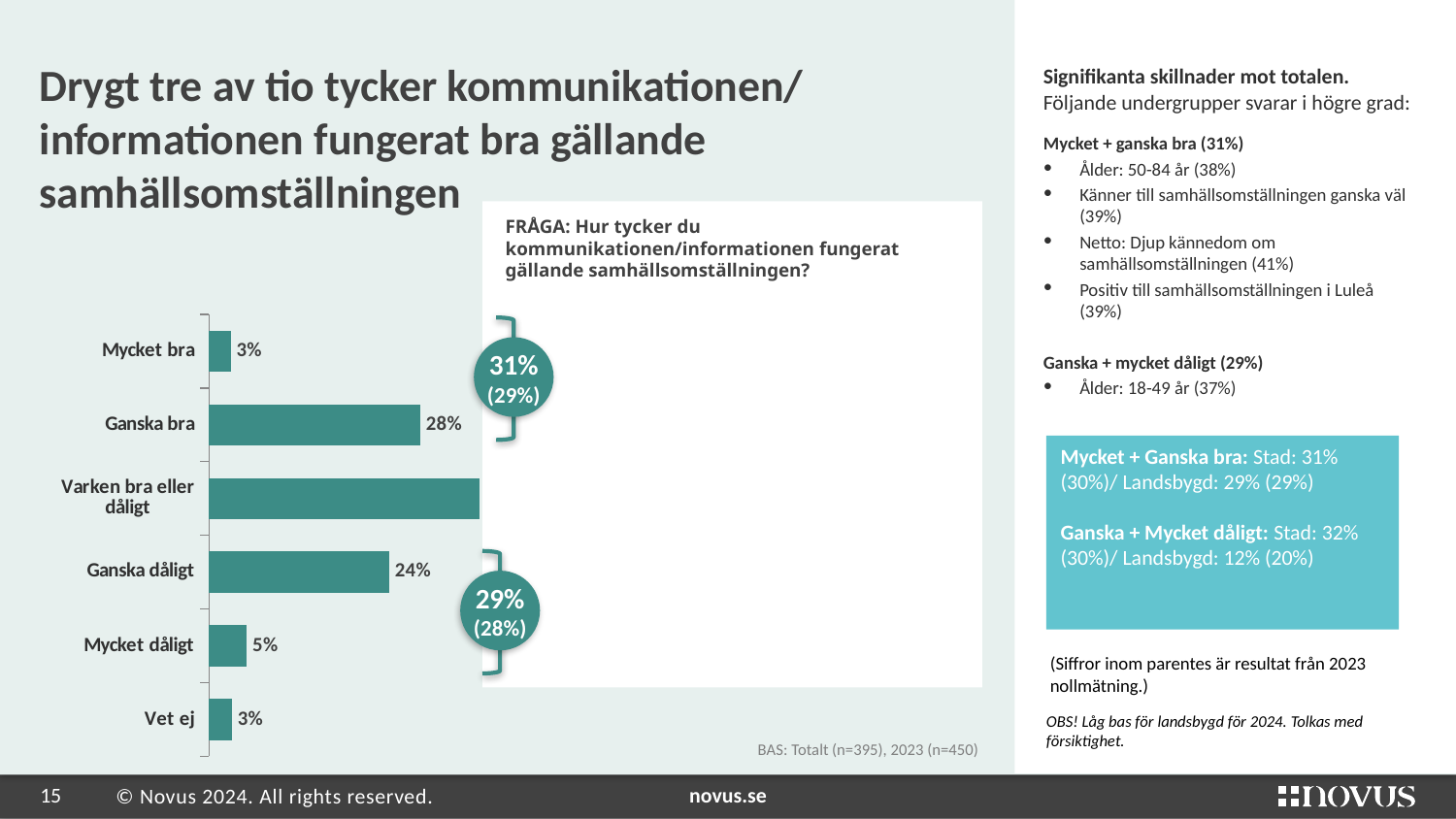
What is the combined share for "Mycket bra" and "Ganska bra" as shown by the bracket label? 31% What is the value shown for "Ganska dåligt"? 24% Which response category has the longest bar in the chart? Varken bra eller dåligt How many response categories are shown in the bar chart? 6 How many percentage points higher is "Ganska bra" than "Ganska dåligt"? 4 What percentage answered "Mycket dåligt"? 5% Which is larger, the value for "Mycket dåligt" or the value for "Mycket bra"? Mycket dåligt According to the bracket label, what was the 2023 result for "Ganska + mycket dåligt" shown in parentheses? 28% What percentage answered "Mycket bra"? 3% What type of chart is used on the slide? Bar chart What is the value for "Vet ej"? 3% What percentage of respondents answered "Ganska bra"? 28%